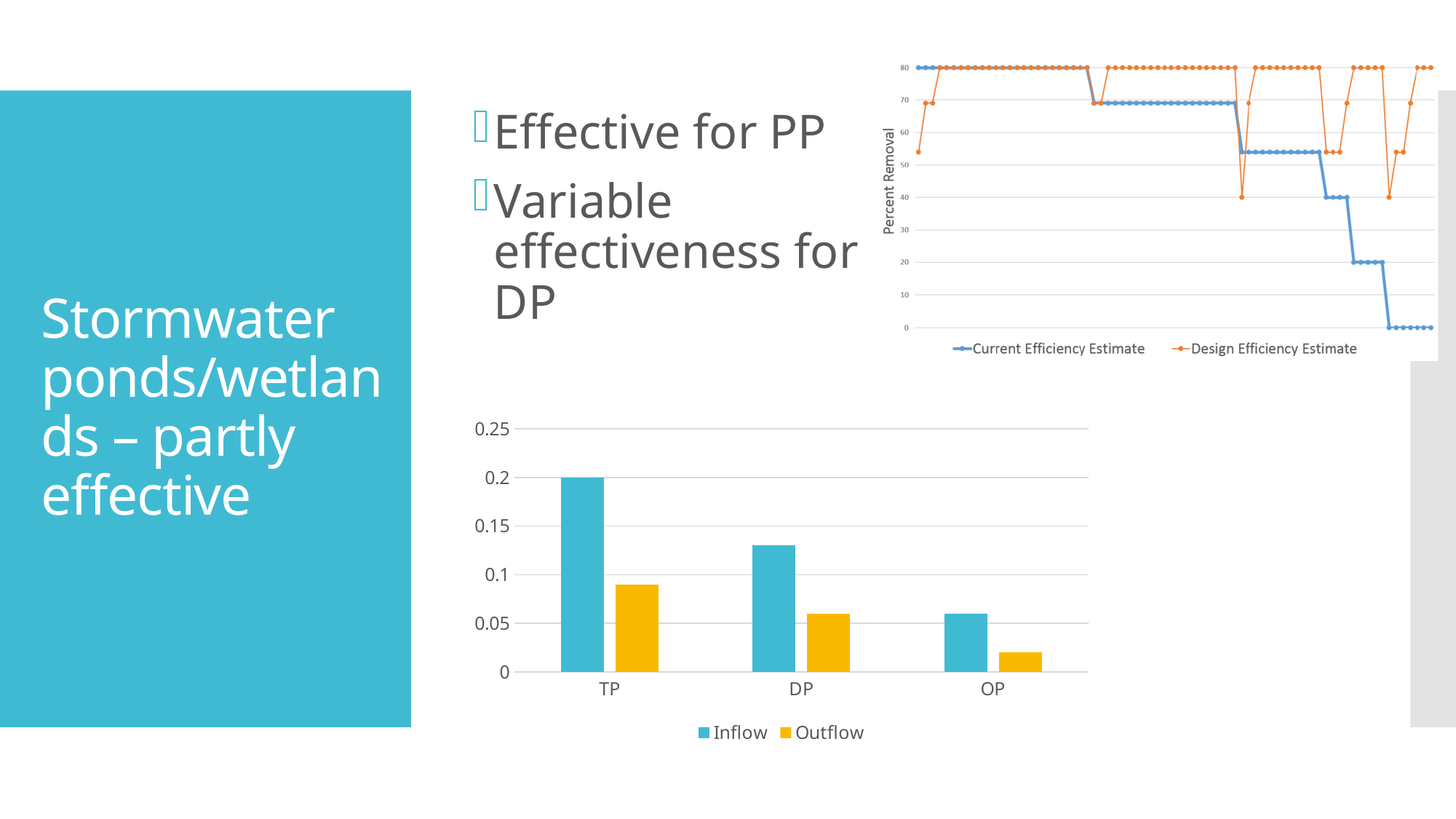
In the bottom bar chart, which is larger for DP: Inflow or Outflow? Inflow In the bottom bar chart, how many categories are shown on the x axis? 3 What type of chart is the top-right chart showing Percent Removal? line chart In the bottom bar chart, how many series does the legend list? 2 In the bottom bar chart, is the Inflow value for DP greater or less than 0.1? greater In the bottom bar chart, what is the Inflow value for TP? 0.2 In the bottom bar chart, is the Outflow value for TP greater or less than 0.1? less What type of chart is the bottom chart with Inflow and Outflow? bar chart In the bottom bar chart, which category has the highest Inflow value? TP In the top-right line chart, how many series does the legend list? 2 In the bottom bar chart, which category has the lowest Outflow value? OP In the top-right line chart, what is the label of the y axis? Percent Removal